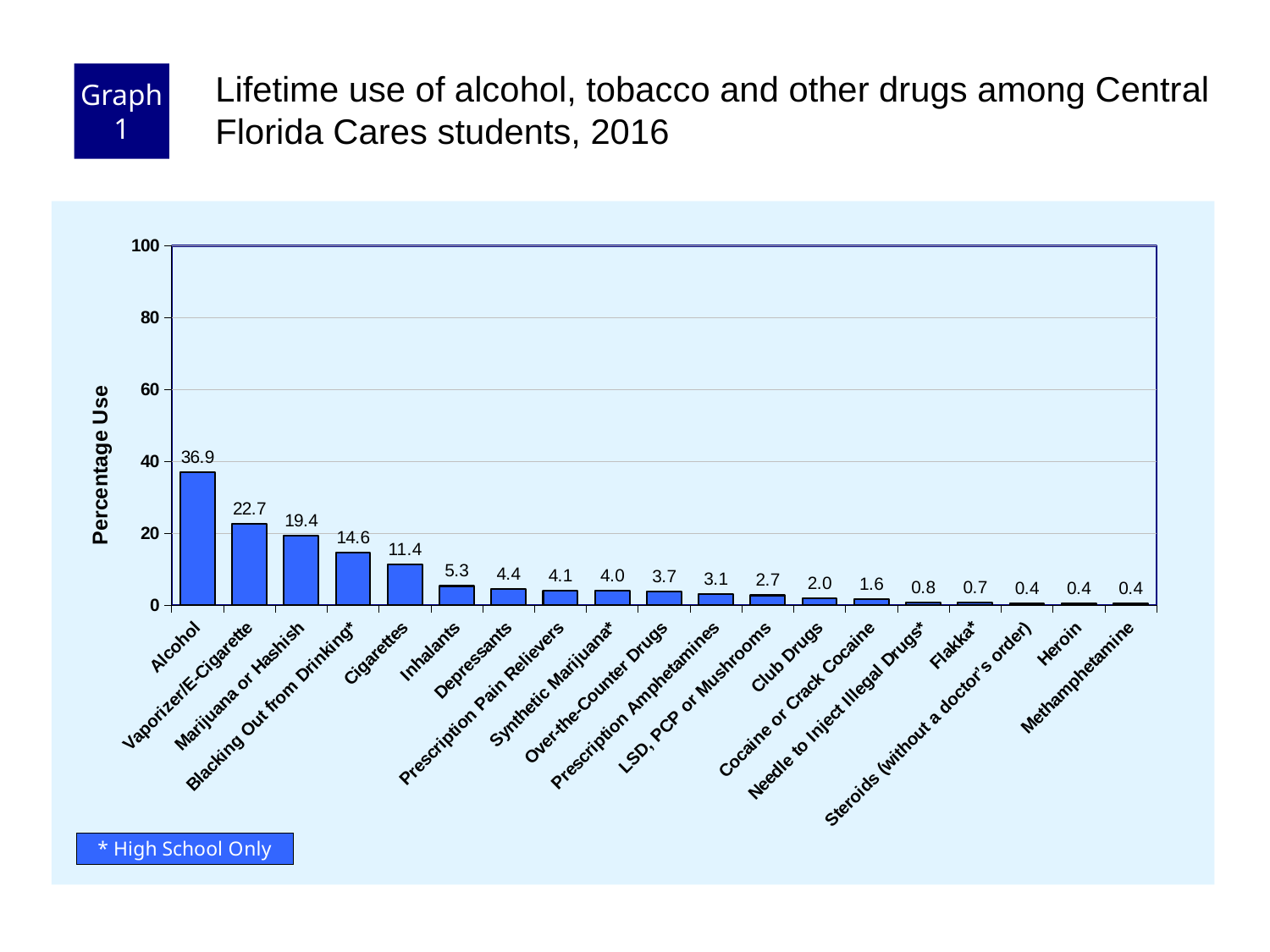
What is the difference in percentage use between Alcohol and Vaporizer/E-Cigarette? 14.2 What is the label of the y axis? Percentage Use What is the percentage use for Inhalants? 5.3 What kind of chart is shown on the slide? Bar chart Which has a higher percentage use, Depressants or Club Drugs? Depressants How many categories are shown on the x axis? 19 What is the percentage use for Cigarettes? 11.4 Which category has the highest percentage use? Alcohol What is the percentage use for Cocaine or Crack Cocaine? 1.6 What is the percentage use for Alcohol? 36.9 What is the difference in percentage use between Marijuana or Hashish and Cigarettes? 8.0 Is the value for Blacking Out from Drinking* greater or less than 20? less